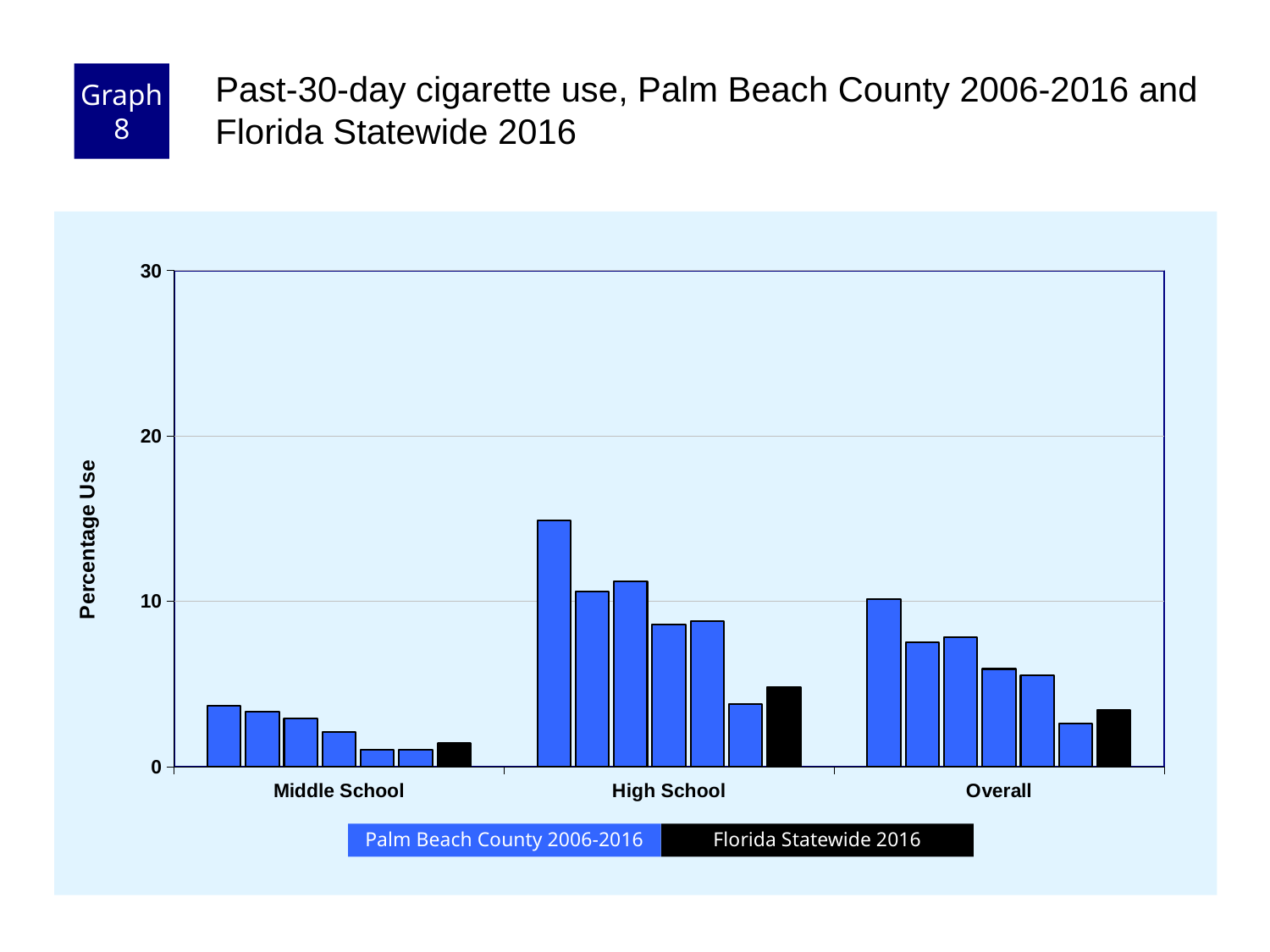
Is the value of the tallest High School bar greater or less than 10? greater What colour represents Florida Statewide 2016 in the legend? black How many categories are shown on the x axis? 3 Which is larger: the Florida Statewide 2016 bar for High School or for Middle School? High School Do the Palm Beach County bars within the High School group generally rise or fall from left to right? fall What is the label on the y axis? Percentage Use Which category has the tallest bar? High School What kind of chart is shown on the slide? bar chart Which category has the lowest bars overall? Middle School How many series does the legend list? 2 Is the Florida Statewide 2016 value for High School greater or less than 10? less Are all the Middle School bars greater or less than 10? less